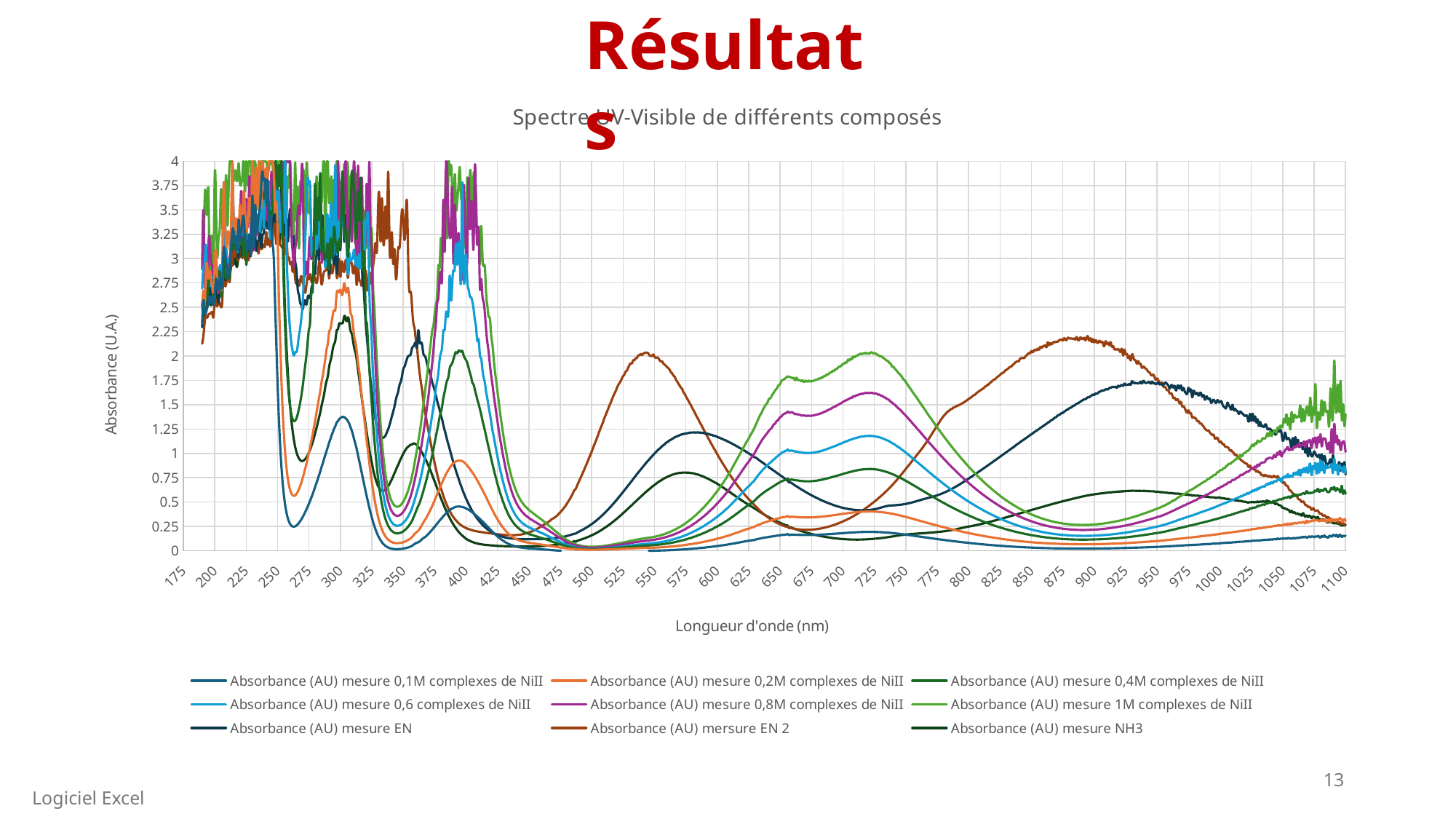
Is the value of the 'Absorbance (AU) mesure 0,1M complexes de NiII' series at 300 nm greater or less than 1? greater Which series has the highest value at 900 nm? Absorbance (AU) mersure EN 2 Is the value of the 'Absorbance (AU) mesure EN' series at 950 nm greater or less than 1.5? greater Is the value of the 'Absorbance (AU) mersure EN 2' series at 550 nm greater or less than 1.75? greater Does the 'Absorbance (AU) mersure EN 2' series rise or fall between 550 nm and 650 nm? fall How many series does the legend list? 9 What is the label of the x axis? Longueur d'onde (nm) What kind of chart is shown on the slide? line chart At 725 nm, which series has the higher value: 'Absorbance (AU) mesure 1M complexes de NiII' or 'Absorbance (AU) mesure 0,8M complexes de NiII'? Absorbance (AU) mesure 1M complexes de NiII What is the title of the chart? Spectre UV-Visible de différents composés At 550 nm, which series has the higher value: 'Absorbance (AU) mersure EN 2' or 'Absorbance (AU) mesure EN'? Absorbance (AU) mersure EN 2